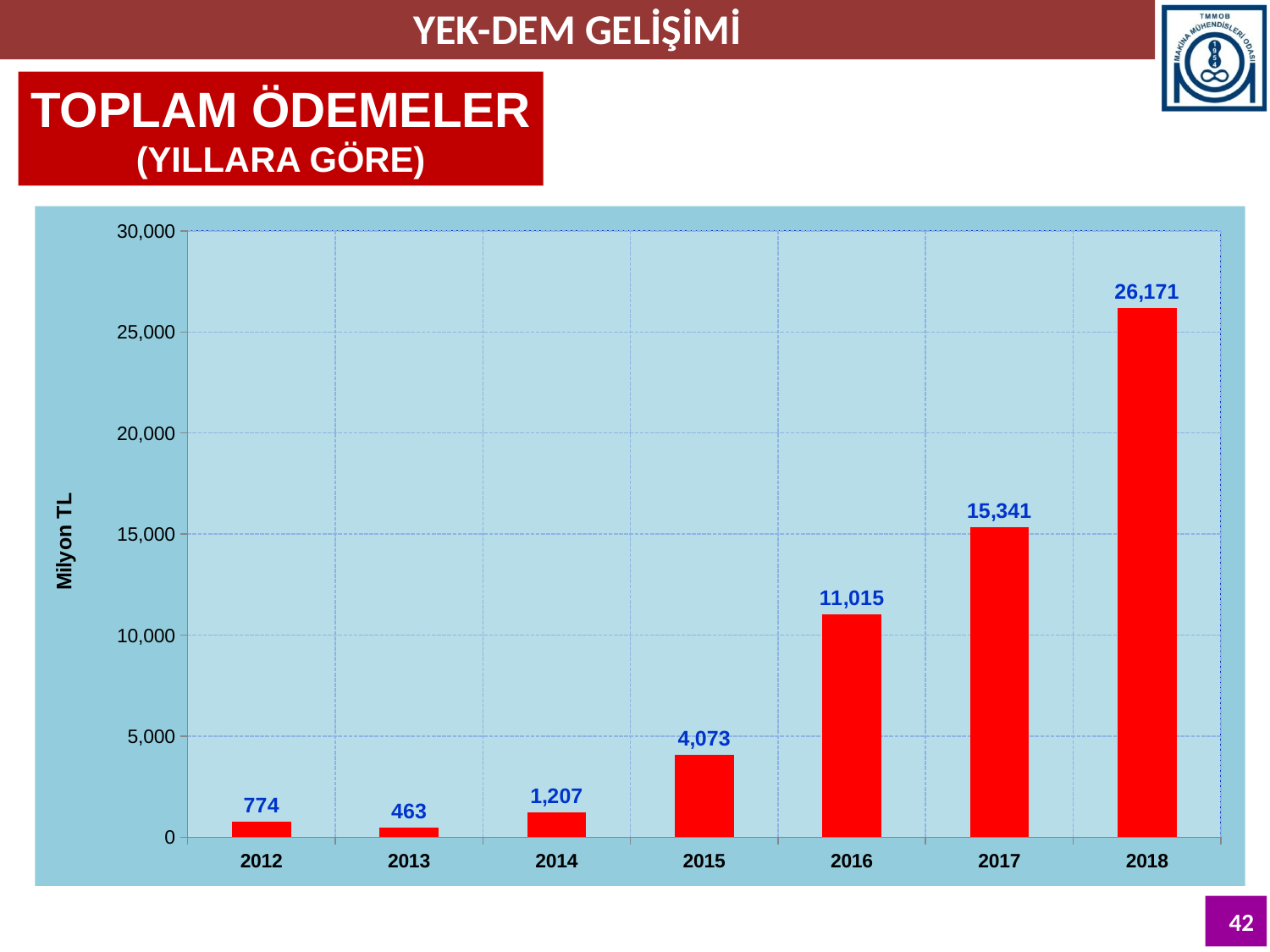
Is the value for 2017 greater or less than 15,000? greater What is the difference between the values for 2018 and 2017? 10,830 What kind of chart is shown? bar chart Which is larger, the value for 2012 or the value for 2013? 2012 Which year has the highest value? 2018 What is the difference between the values for 2015 and 2014? 2,866 Which year has the lowest value? 2013 How many years are shown on the x axis? 7 What is the value for 2018? 26,171 What is the label of the vertical axis? Milyon TL What is the value for 2016? 11,015 What is the value for 2013? 463